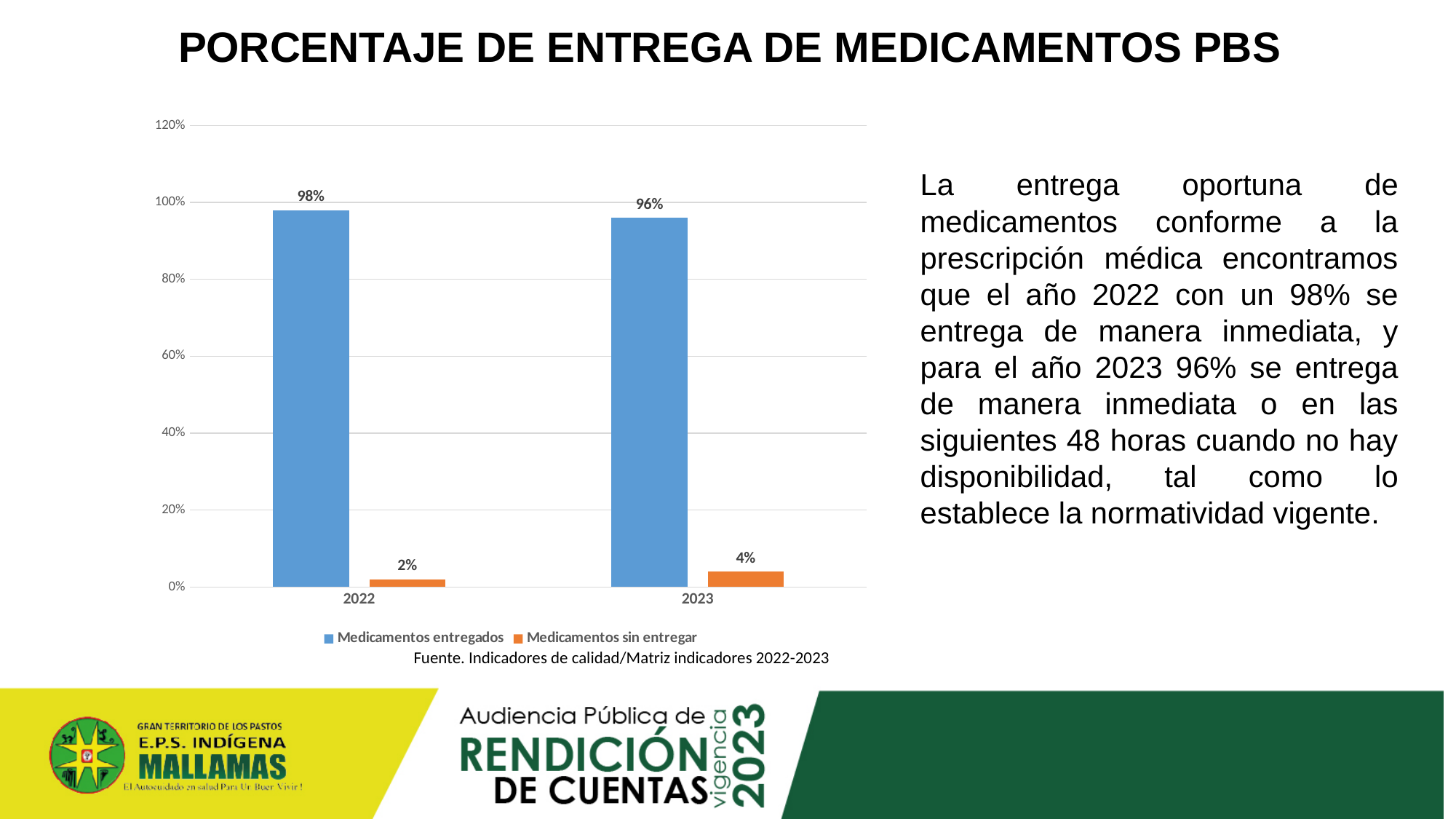
Is the value for Medicamentos sin entregar in 2023 larger than the value for Medicamentos sin entregar in 2022? Yes How many years are shown on the x axis? 2 What kind of chart is shown on the slide? Bar chart What is the value for Medicamentos entregados in 2023? 96% Does the value for Medicamentos entregados rise or fall from 2022 to 2023? Fall Which year has the higher value for Medicamentos entregados? 2022 What is the value for Medicamentos sin entregar in 2022? 2% How many series does the legend list? 2 Which year has the lower value for Medicamentos sin entregar? 2022 What is the difference between Medicamentos entregados in 2022 and in 2023? 2% What is the value for Medicamentos sin entregar in 2023? 4% What is the value for Medicamentos entregados in 2022? 98%